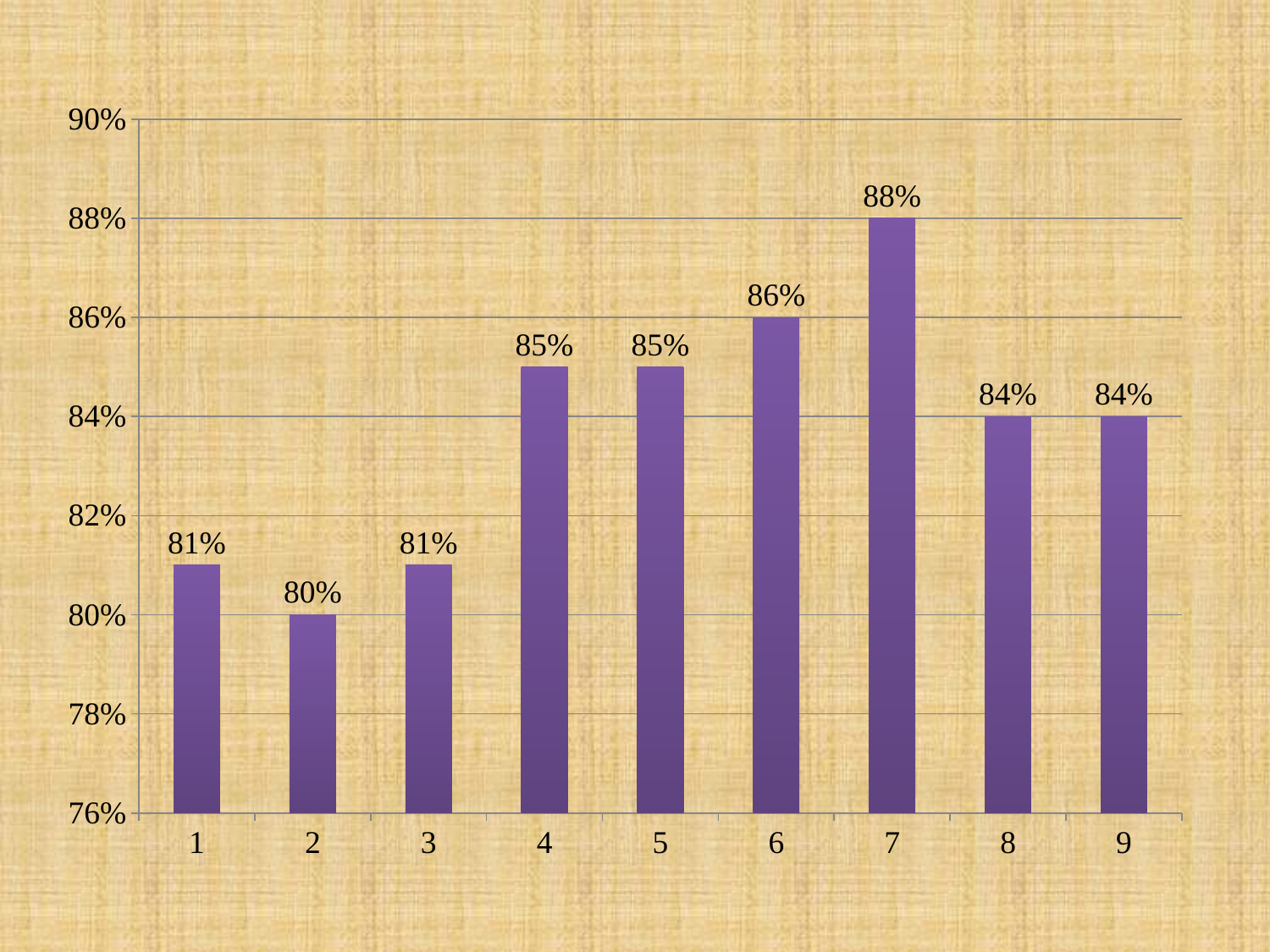
Which category has the lowest value? 2 Is the value for category 6 greater or less than 84%? greater What is the value for category 5? 85% What is the difference between the values for category 7 and category 2? 8% What is the value for category 7? 88% What kind of chart is shown on the slide? bar chart Which category has the highest value? 7 Which is larger, the value for category 4 or the value for category 3? category 4 How many categories are shown on the x axis? 9 What is the value for category 2? 80% What is the value for category 9? 84% What is the difference between the values for category 6 and category 1? 5%